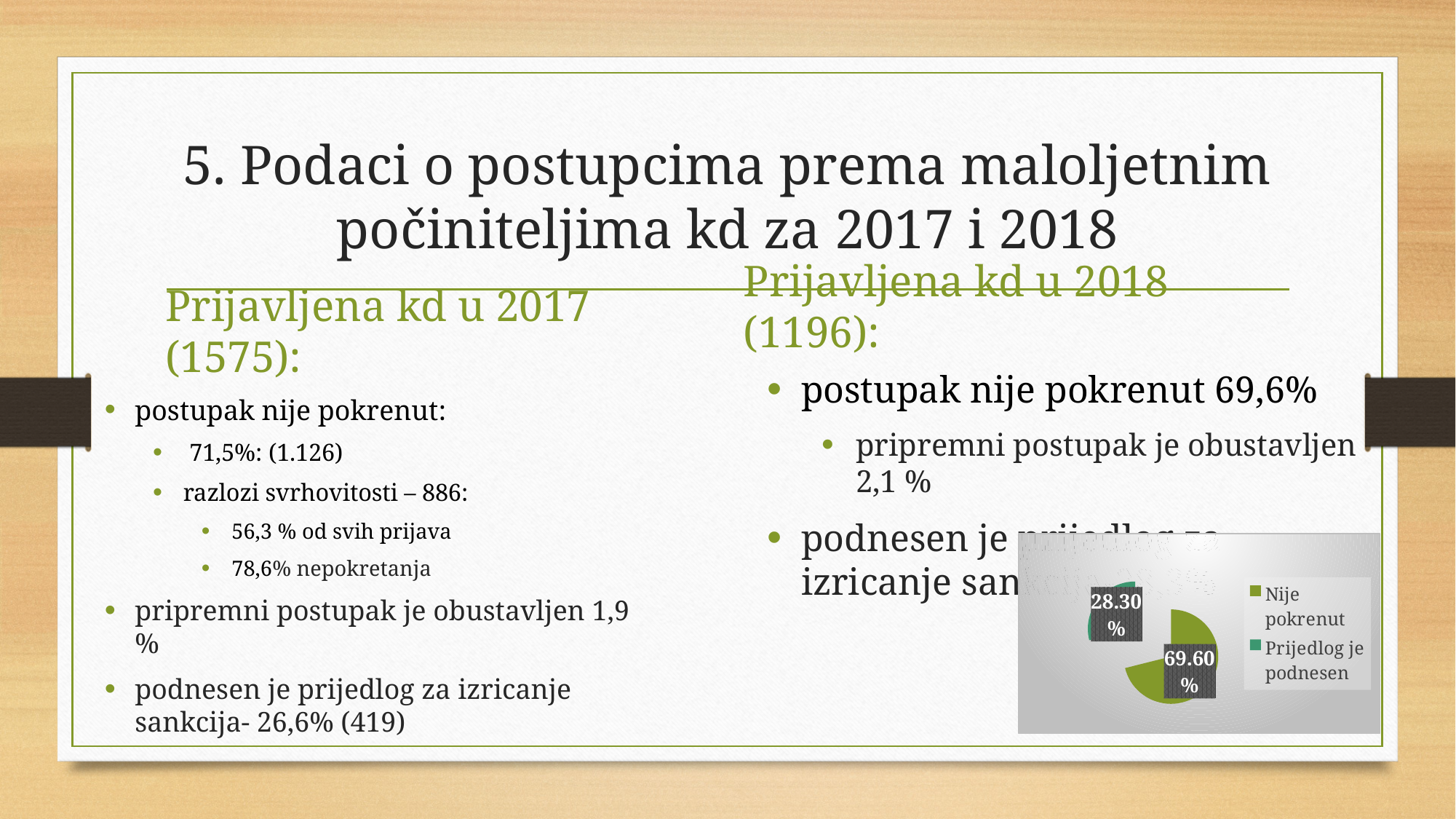
What is the difference between the "Nije pokrenut" and "Prijedlog je podnesen" slices in the pie chart? 41.30% How many entries does the legend of the pie chart list? 2 What colour is the "Nije pokrenut" slice in the pie chart? green Which slice of the pie chart is the largest? Nije pokrenut Which slice of the pie chart is the smallest? Prijedlog je podnesen What share of the pie does the "Nije pokrenut" slice represent? 69.60% Which is larger in the pie chart, "Nije pokrenut" or "Prijedlog je podnesen"? Nije pokrenut What is the value for "Nije pokrenut" in the pie chart? 69.60% What is the value for "Prijedlog je podnesen" in the pie chart? 28.30% What kind of chart is shown on the slide? pie chart Where is the legend positioned relative to the pie chart? to the right How many slices does the pie chart have? 2